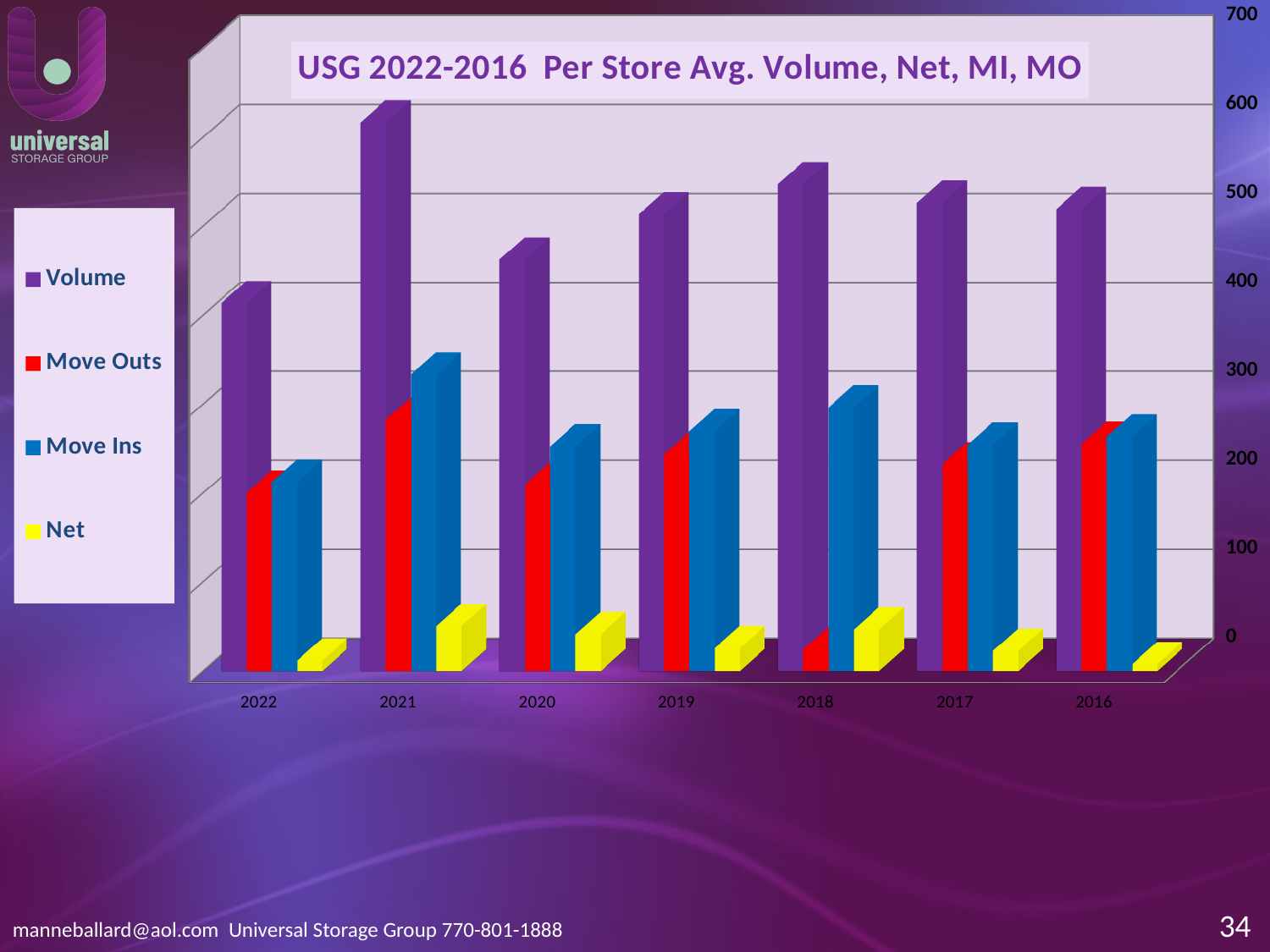
What kind of chart is shown on the slide? bar chart Which year has the highest Move Ins bar? 2021 Which colour represents the Net series in the legend? yellow How many series does the legend list? 4 Which year has the lowest Move Outs bar? 2018 Which is larger, the Volume for 2021 or the Volume for 2022? 2021 Which year has the lowest Volume bar? 2022 What is the title of the chart? USG 2022-2016 Per Store Avg. Volume, Net, MI, MO Is the Volume value for 2022 greater or less than 500? less Is the Volume value for 2021 greater or less than 500? greater How many years are shown along the x axis? 7 Which year has the highest Volume bar? 2021